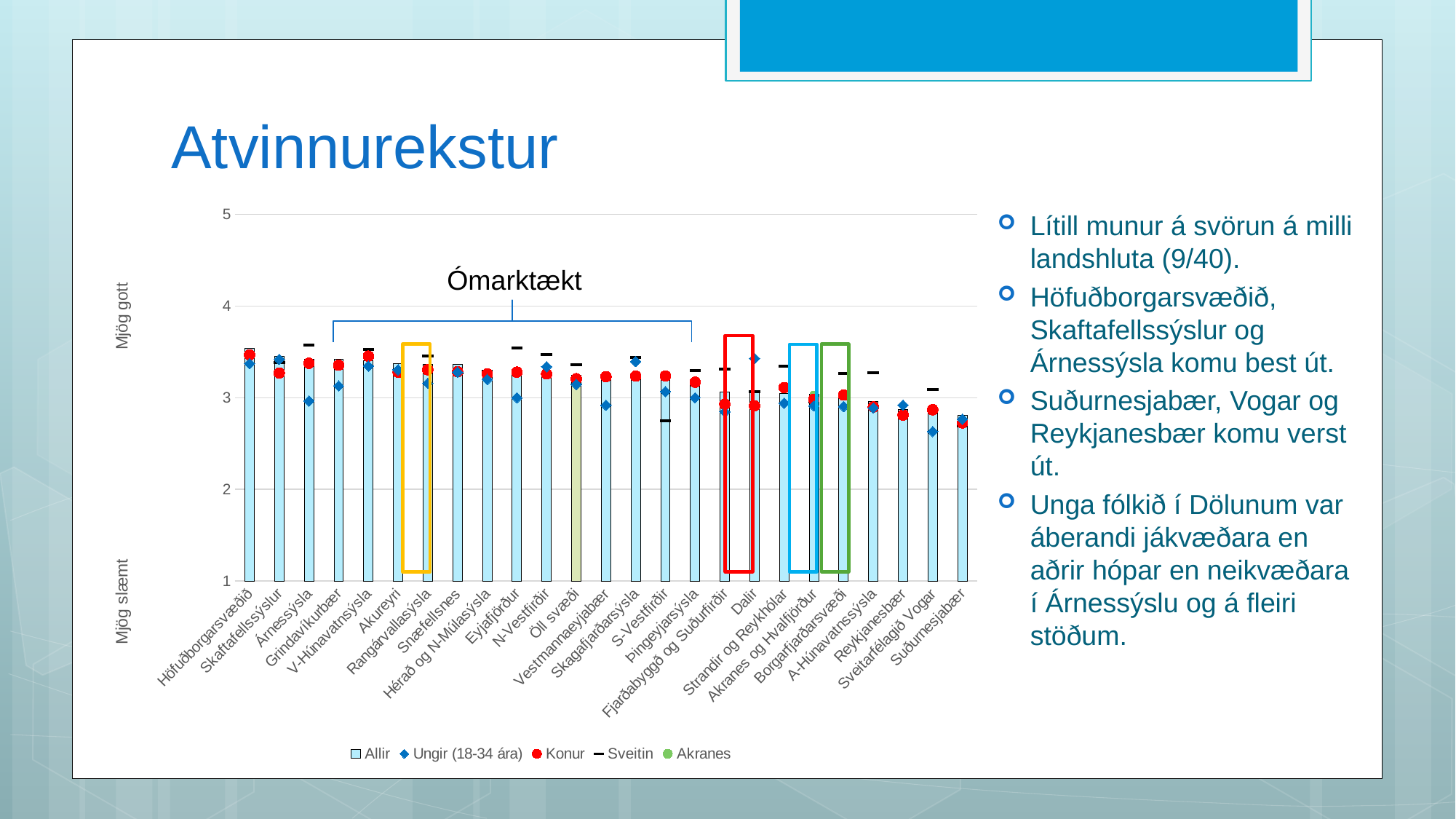
How many categories are shown along the x axis of the chart? 25 What annotation text is written above the bracketed group of bars in the middle of the chart? Ómarktækt Is the Ungir (18-34 ára) value for Dalir greater or less than 3? greater Is the Allir value for Höfuðborgarsvæðið greater or less than 3? greater Is the Allir value for Suðurnesjabær greater or less than 3? less What kind of chart is shown on the slide? bar chart Which has the larger Ungir (18-34 ára) value, Dalir or Sveitarfélagið Vogar? Dalir Which has the larger Allir value, Höfuðborgarsvæðið or Suðurnesjabær? Höfuðborgarsvæðið Do the Allir bar values generally rise or fall from left to right along the x axis? fall How many series does the chart legend list? 5